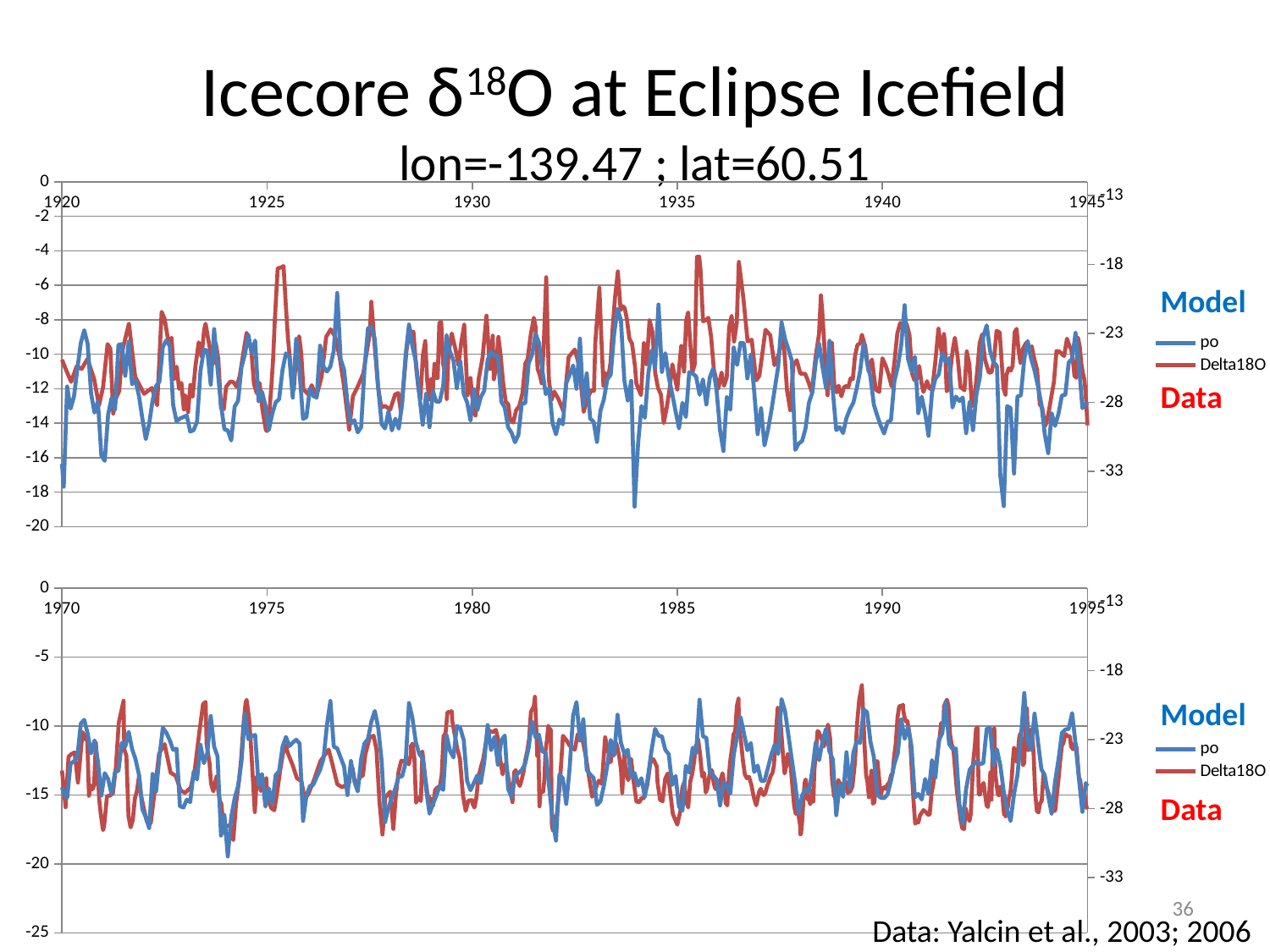
What is the last year shown on the x axis of the bottom chart? 1995 What is the lowest tick value on the left y axis of the bottom chart? -25 What kind of chart is the top chart on the slide? line chart What is the first year shown on the x axis of the top chart? 1920 What kind of chart is the bottom chart on the slide? line chart What is the lowest tick value on the left y axis of the top chart? -20 How many series does the legend of the top chart list? 2 How many series does the legend of the bottom chart list? 2 What are the two legend entries of the top chart? po and Delta18O What is the first year shown on the x axis of the bottom chart? 1970 In the bottom chart, which legend entry is drawn in red? Delta18O What is the last year shown on the x axis of the top chart? 1945